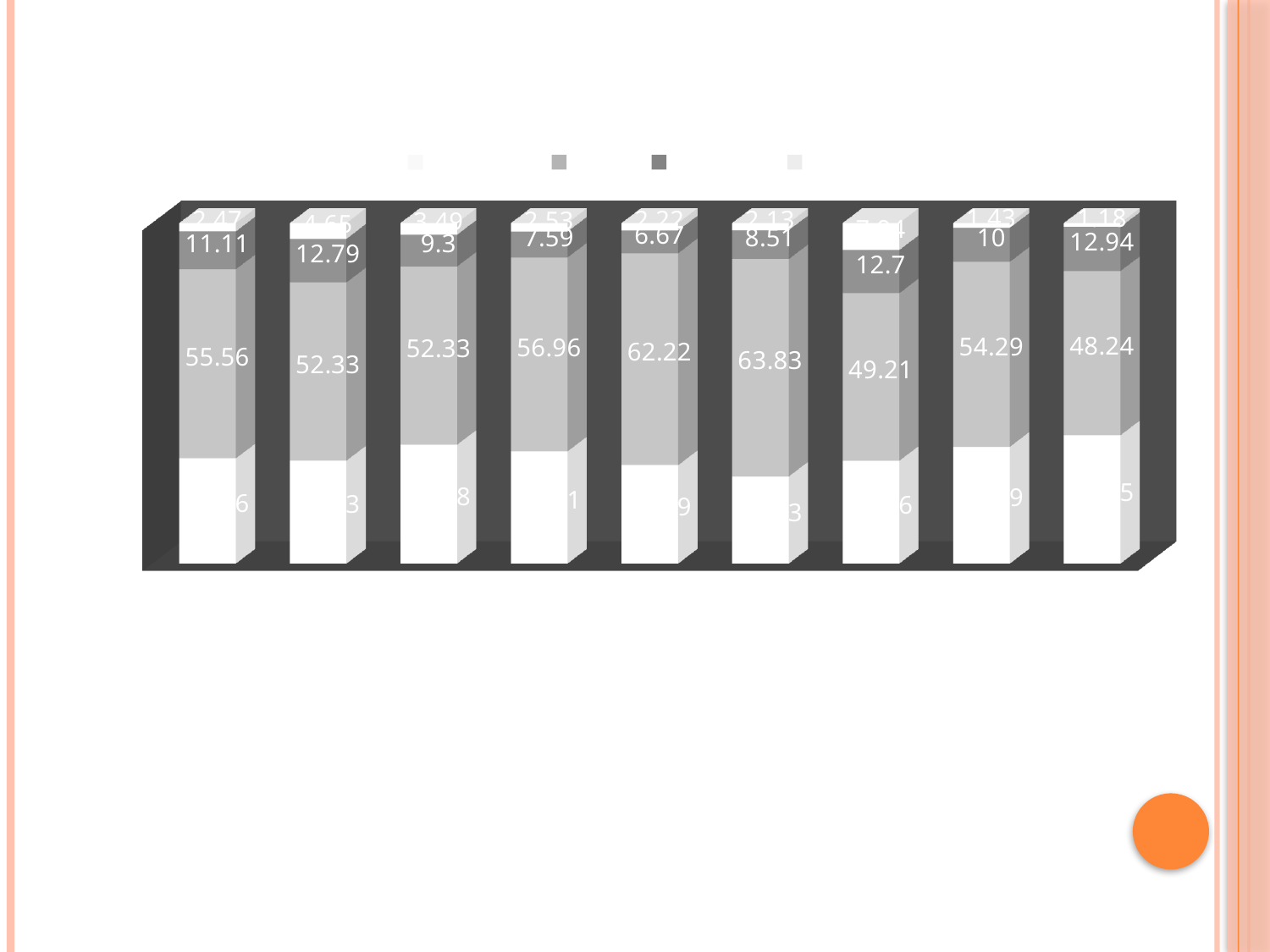
What is the value of the large light-grey segment in the sixth bar from the left? 63.83 What is the difference between the light-grey segment values of the sixth bar (63.83) and the seventh bar (49.21)? 14.62 What is the value of the large light-grey segment in the fifth bar from the left? 62.22 What kind of chart is shown on the slide? stacked bar chart How many series does the legend show? 4 What is the value of the dark-grey segment in the eighth bar from the left? 10 What is the value of the large light-grey segment in the first bar from the left? 55.56 Is the dark-grey segment larger in the second bar from the left (12.79) or the fifth bar from the left (6.67)? the second bar from the left Which bar has the lowest value for the large light-grey segment? the last bar on the right (48.24) What is the value of the large light-grey segment in the last bar on the right? 48.24 Which bar has the highest value for the large light-grey segment? the sixth bar from the left (63.83) How many bars are plotted in the chart? 9